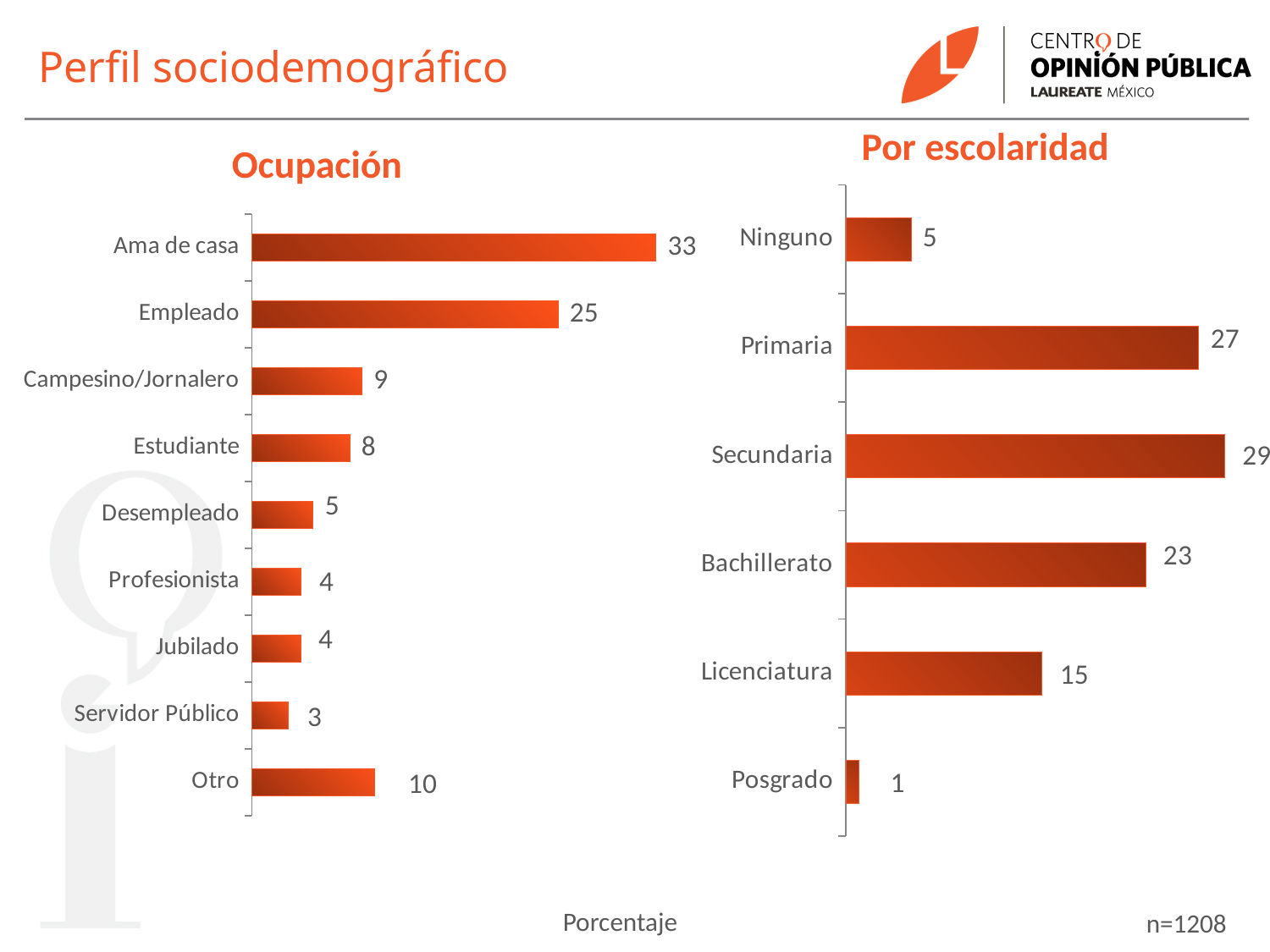
In the Por escolaridad chart, which category has the lowest value? Posgrado In the Ocupación chart, how many categories are shown? 9 In the Ocupación chart, what is the difference between Ama de casa and Empleado? 8 In the Ocupación chart, what is the value for Ama de casa? 33 In the Ocupación chart, which is larger, Estudiante or Otro? Otro In the Por escolaridad chart, which category has the highest value? Secundaria What kind of chart is the Por escolaridad chart? Bar chart In the Por escolaridad chart, what is the difference between Secundaria and Bachillerato? 6 In the Ocupación chart, what is the value for Campesino/Jornalero? 9 In the Por escolaridad chart, how many categories are shown? 6 In the Por escolaridad chart, what is the value for Licenciatura? 15 In the Ocupación chart, which category has the lowest value? Servidor Público